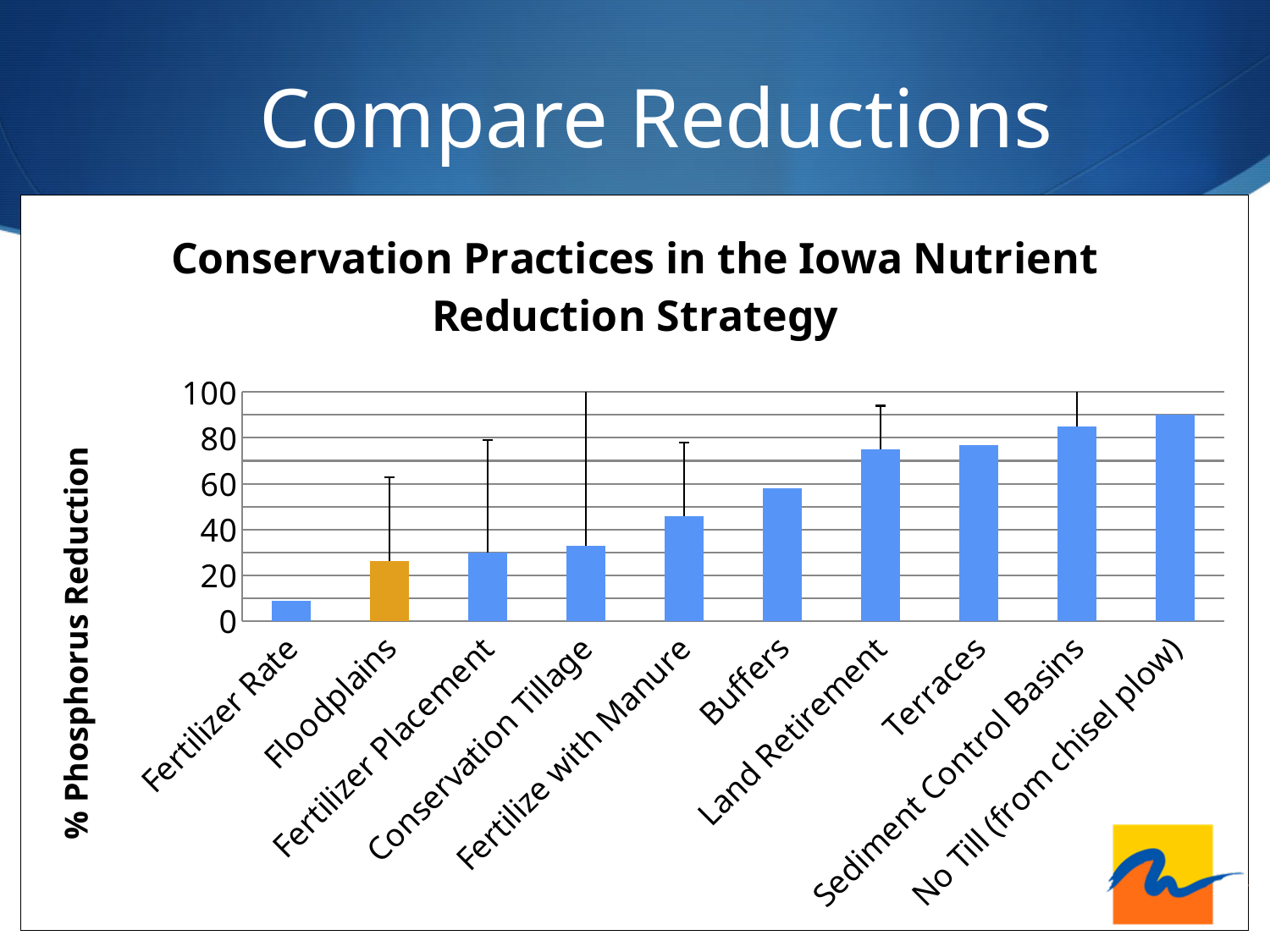
Is the value for Fertilizer Rate greater or less than 20? less What kind of chart is shown on the slide? bar chart Do the bar values rise or fall moving from left to right along the x axis? rise Is the value for Conservation Tillage greater or less than 40? less Which conservation practice is shown with an orange bar instead of a blue one? Floodplains Which conservation practice has the highest % phosphorus reduction? No Till (from chisel plow) How many conservation practices (categories) are plotted on the chart? 10 Is the value for Land Retirement greater or less than 60? greater Which has a larger % phosphorus reduction, Buffers or Fertilize with Manure? Buffers Which conservation practice has the lowest % phosphorus reduction? Fertilizer Rate